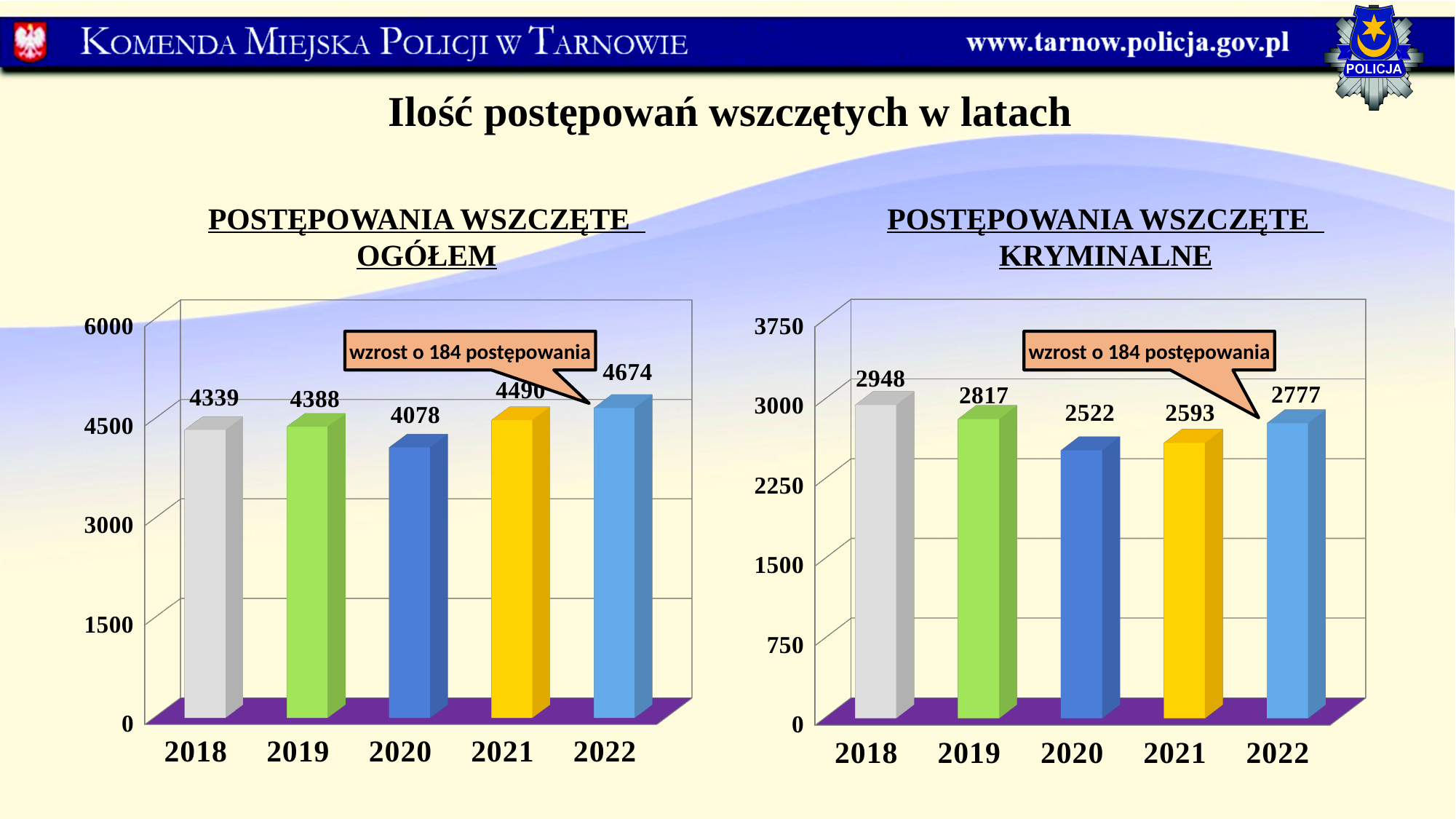
In the chart titled POSTĘPOWANIA WSZCZĘTE KRYMINALNE, which year has the highest value? 2018 How many years are shown on the x axis of the chart titled POSTĘPOWANIA WSZCZĘTE KRYMINALNE? 5 In the chart titled POSTĘPOWANIA WSZCZĘTE OGÓŁEM, do the values rise or fall from 2020 to 2022? rise In the chart titled POSTĘPOWANIA WSZCZĘTE KRYMINALNE, what is the value for 2020? 2522 In the chart titled POSTĘPOWANIA WSZCZĘTE KRYMINALNE, which is larger, the value for 2021 or the value for 2022? 2022 In the chart titled POSTĘPOWANIA WSZCZĘTE KRYMINALNE, what is the difference between the values for 2018 and 2019? 131 In the chart titled POSTĘPOWANIA WSZCZĘTE OGÓŁEM, what is the difference between the values for 2022 and 2021? 184 What kind of chart is the chart titled POSTĘPOWANIA WSZCZĘTE OGÓŁEM? bar chart In the chart titled POSTĘPOWANIA WSZCZĘTE OGÓŁEM, which year has the lowest value? 2020 In the chart titled POSTĘPOWANIA WSZCZĘTE OGÓŁEM, is the value for 2020 greater or less than 4500? less What does the callout on the chart titled POSTĘPOWANIA WSZCZĘTE KRYMINALNE say? wzrost o 184 postępowania In the chart titled POSTĘPOWANIA WSZCZĘTE OGÓŁEM, what is the value for 2022? 4674